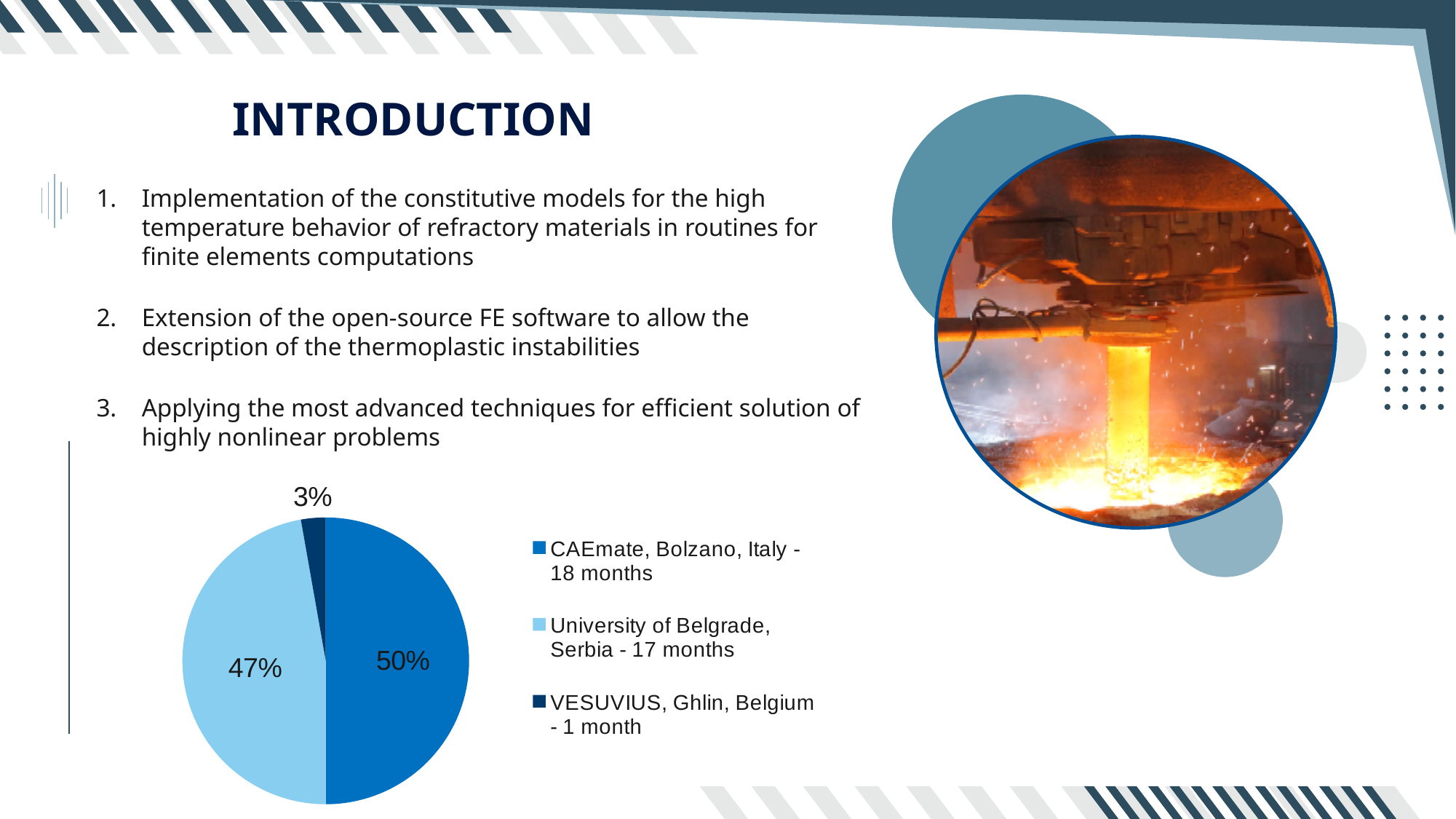
Which slice of the pie chart is the smallest? VESUVIUS, Ghlin, Belgium - 1 month Which is larger, the share for University of Belgrade, Serbia or the share for VESUVIUS, Ghlin, Belgium? University of Belgrade, Serbia How many months does the legend give for University of Belgrade, Serbia? 17 months What is the difference in percentage points between the CAEmate slice and the University of Belgrade slice? 3 What kind of chart is shown on the slide? pie chart What colour is the slice for VESUVIUS, Ghlin, Belgium in the pie chart? dark navy blue What share of the pie does CAEmate, Bolzano, Italy have? 50% How many entries does the legend of the pie chart list? 3 Which slice of the pie chart is the largest? CAEmate, Bolzano, Italy - 18 months How many slices does the pie chart have? 3 What share of the pie does VESUVIUS, Ghlin, Belgium have? 3% What share of the pie does University of Belgrade, Serbia have? 47%